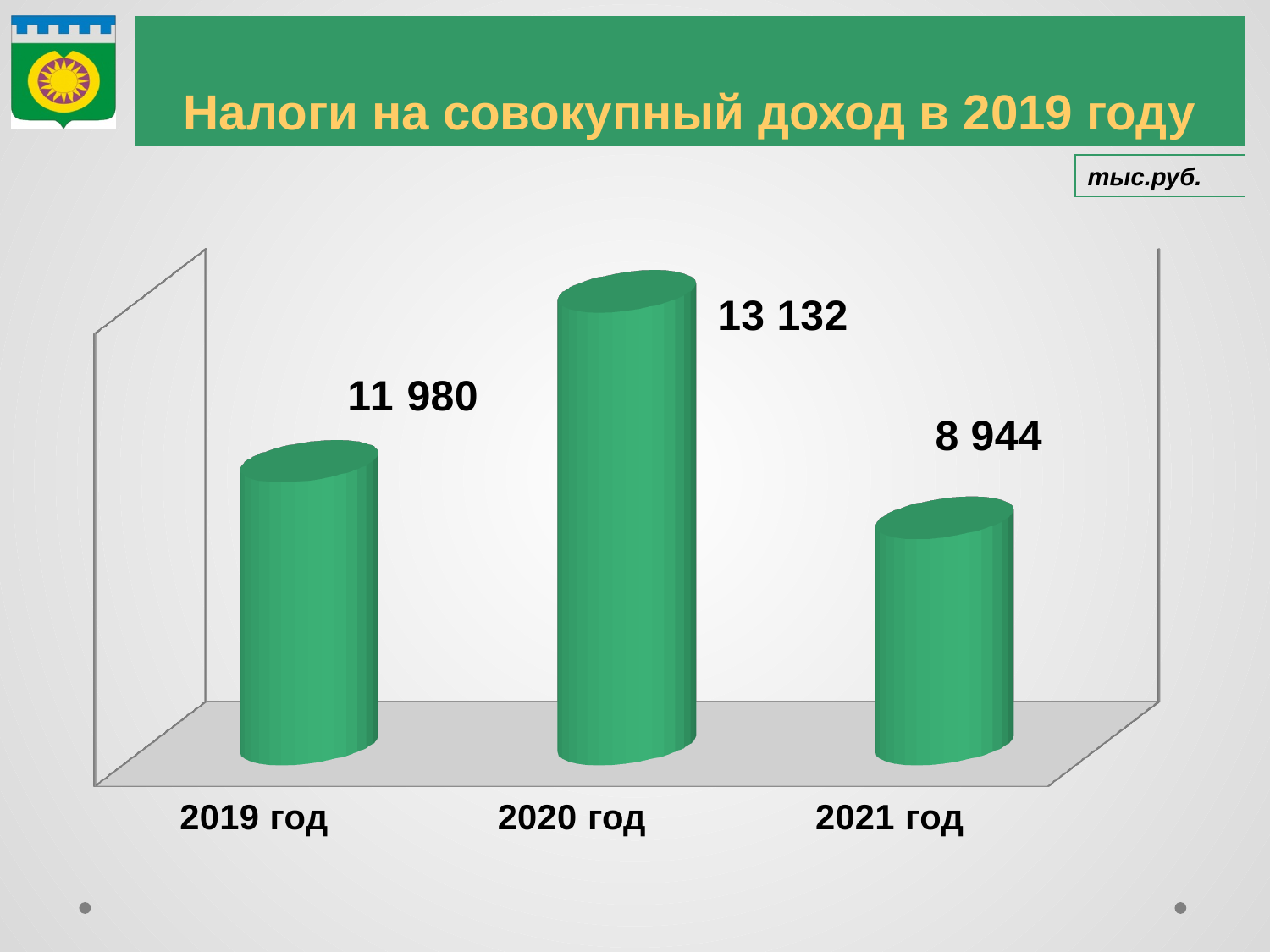
Which year has the highest value? 2020 год Which year has the lowest value? 2021 год What kind of chart is shown on the slide? bar chart What unit is indicated for the values in the chart? тыс.руб. What is the value for 2019 год? 11 980 What is the value for 2020 год? 13 132 What is the difference between the values for 2019 год and 2021 год? 3 036 What is the difference between the values for 2020 год and 2019 год? 1 152 What is the value for 2021 год? 8 944 Which is larger, the value for 2019 год or the value for 2021 год? 2019 год What is the title of the chart? Налоги на совокупный доход в 2019 году How many categories are shown in the chart? 3